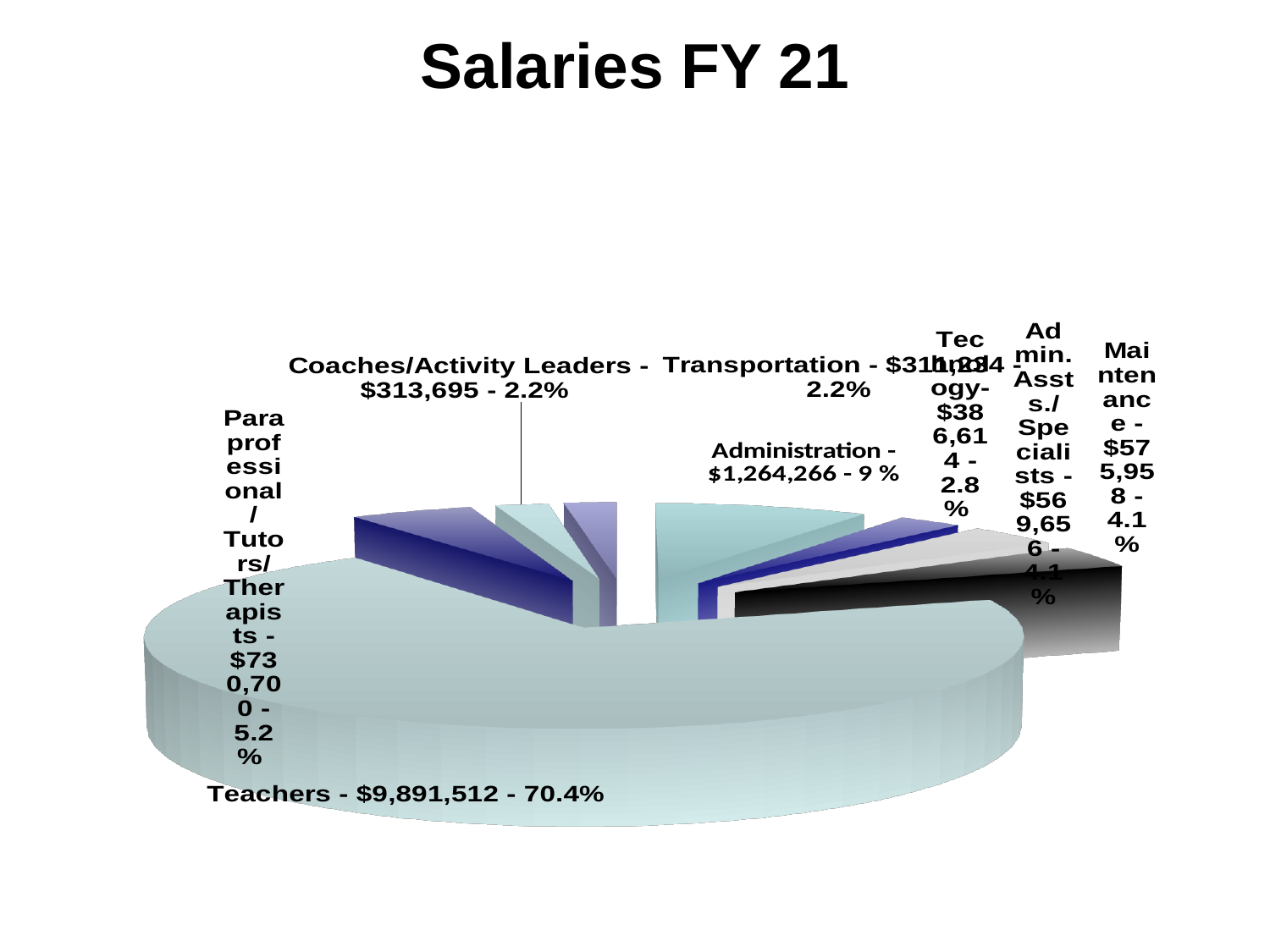
What share of the pie do Teachers represent? 70.4% What is the salary amount shown for Teachers? $9,891,512 What is the salary amount shown for Administration? $1,264,266 Which is larger, the share for Paraprofessional/Tutors/Therapists or the share for Maintenance? Paraprofessional/Tutors/Therapists What is the salary amount shown for Maintenance? $575,958 Which category has the largest slice of the pie? Teachers What share of the pie does Technology represent? 2.8% What share of the pie does Administration represent? 9 % What is the title of the chart? Salaries FY 21 What is the difference between the Teachers salary amount and the Administration salary amount? $8,627,246 How many categories are shown in the pie chart? 8 What kind of chart is shown on the slide? pie chart